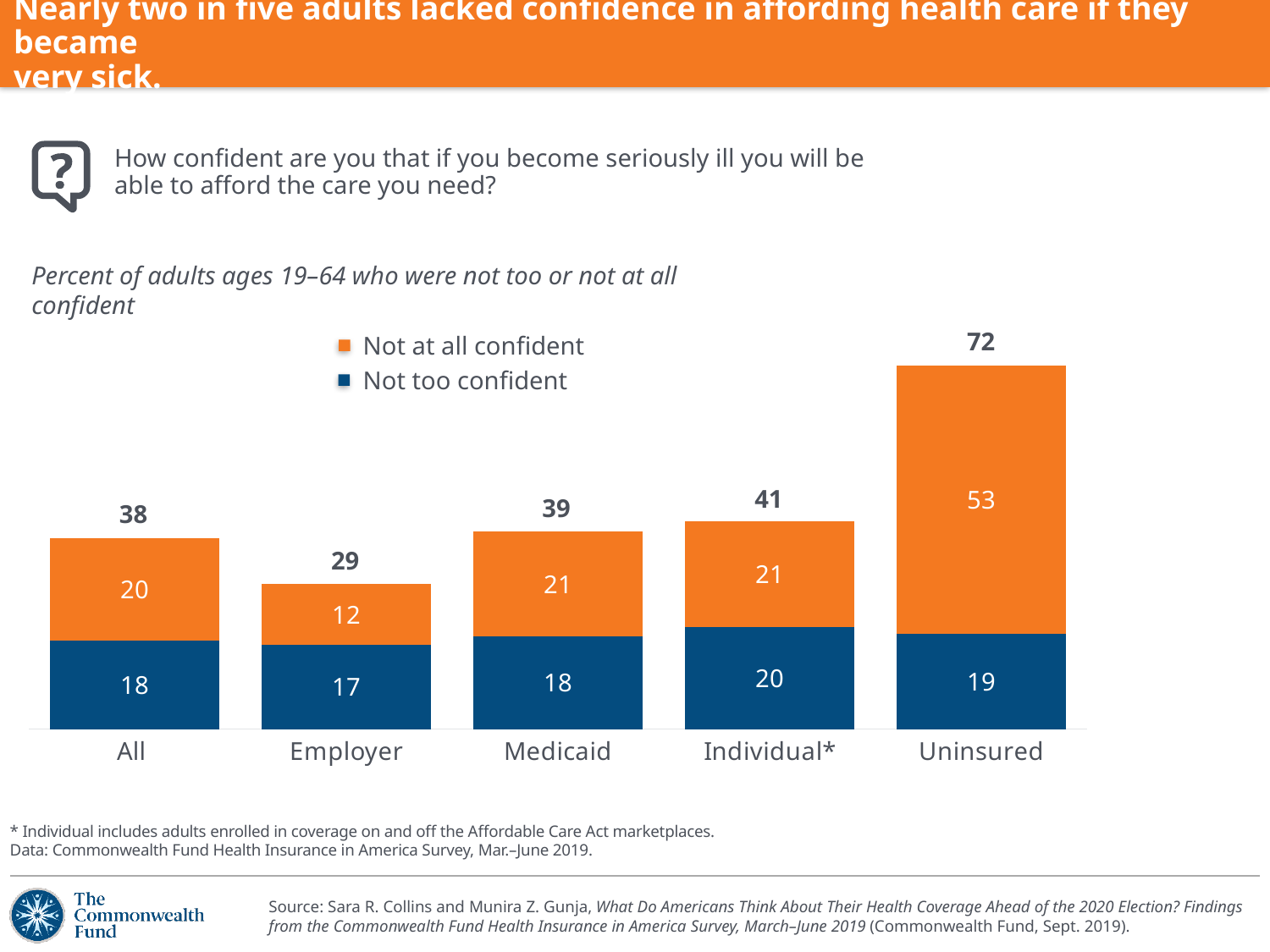
Which legend entry is shown in orange? Not at all confident How many categories are shown on the x axis? 5 What is the 'Not at all confident' value for the All category? 20 Which category has the lowest total? Employer What is the difference between the Uninsured total and the Employer total? 43 What is the 'Not too confident' value for Employer? 17 Is the 'Not at all confident' value larger for Medicaid or for Employer? Medicaid What is the 'Not at all confident' value for Uninsured adults? 53 Which category has the highest total? Uninsured What is the total for the Individual* bar? 41 What kind of chart is shown? Stacked bar chart How many series does the legend list? 2